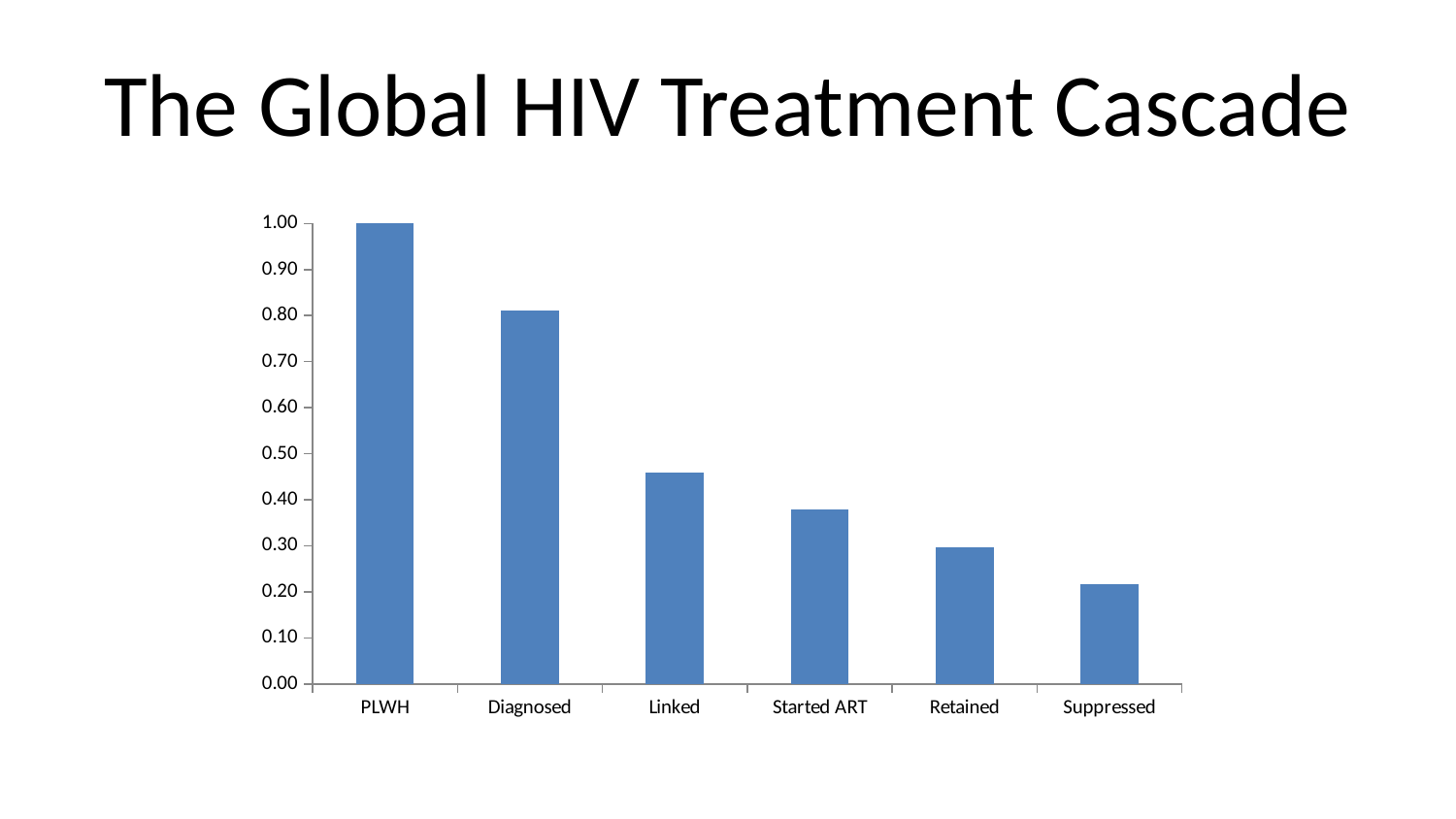
What is the title of the slide? The Global HIV Treatment Cascade Do the values rise or fall from PLWH to Suppressed along the x axis? fall What kind of chart is shown on the slide? bar chart How many categories are shown on the x axis? 6 Is the value for Suppressed greater or less than 0.30? less What is the value for PLWH? 1.00 Which category has the lowest value? Suppressed Which is larger, the value for Diagnosed or the value for Linked? Diagnosed Is the value for Diagnosed greater or less than 0.90? less Is the value for Started ART greater or less than 0.30? greater Which category has the highest value? PLWH